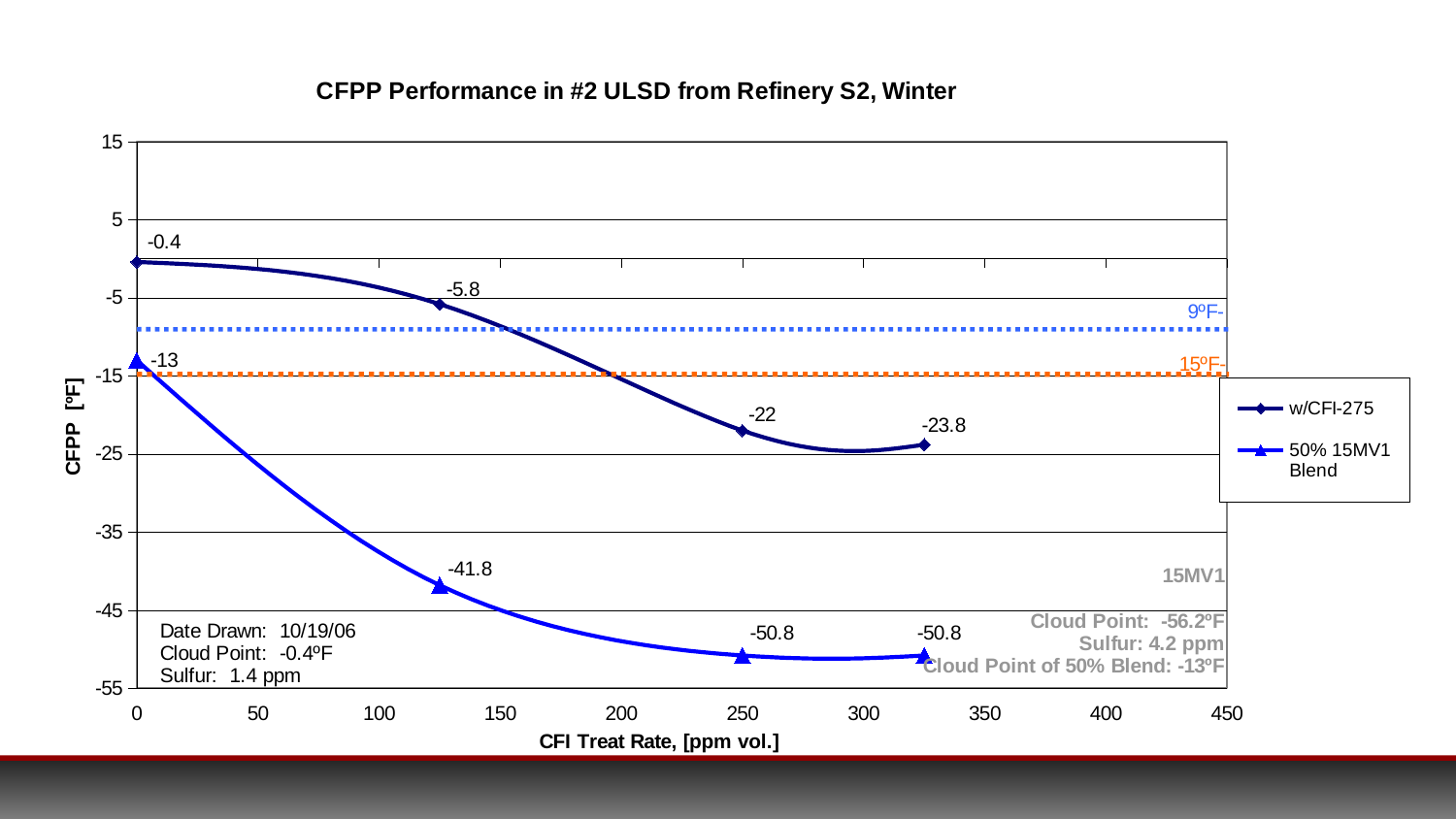
What kind of chart is shown on the slide? line chart Do the CFPP values for the w/CFI-275 series rise or fall as the CFI treat rate increases? fall What is the lowest labeled CFPP value for the w/CFI-275 series? -23.8 What is the title of the chart? CFPP Performance in #2 ULSD from Refinery S2, Winter What is the CFPP value for the 50% 15MV1 Blend series at a CFI treat rate of 250 ppm? -50.8 What is the CFPP value for the 50% 15MV1 Blend series at a CFI treat rate of 0 ppm? -13 How many data points are plotted for the w/CFI-275 series? 4 At a CFI treat rate of 250 ppm, which series has the higher CFPP value? w/CFI-275 At a CFI treat rate of 0 ppm, what is the difference between the w/CFI-275 value and the 50% 15MV1 Blend value? 12.6 What is the CFPP value for the w/CFI-275 series at a CFI treat rate of 250 ppm? -22 What is the CFPP value for the w/CFI-275 series at a CFI treat rate of 0 ppm? -0.4 How many series does the legend list? 2